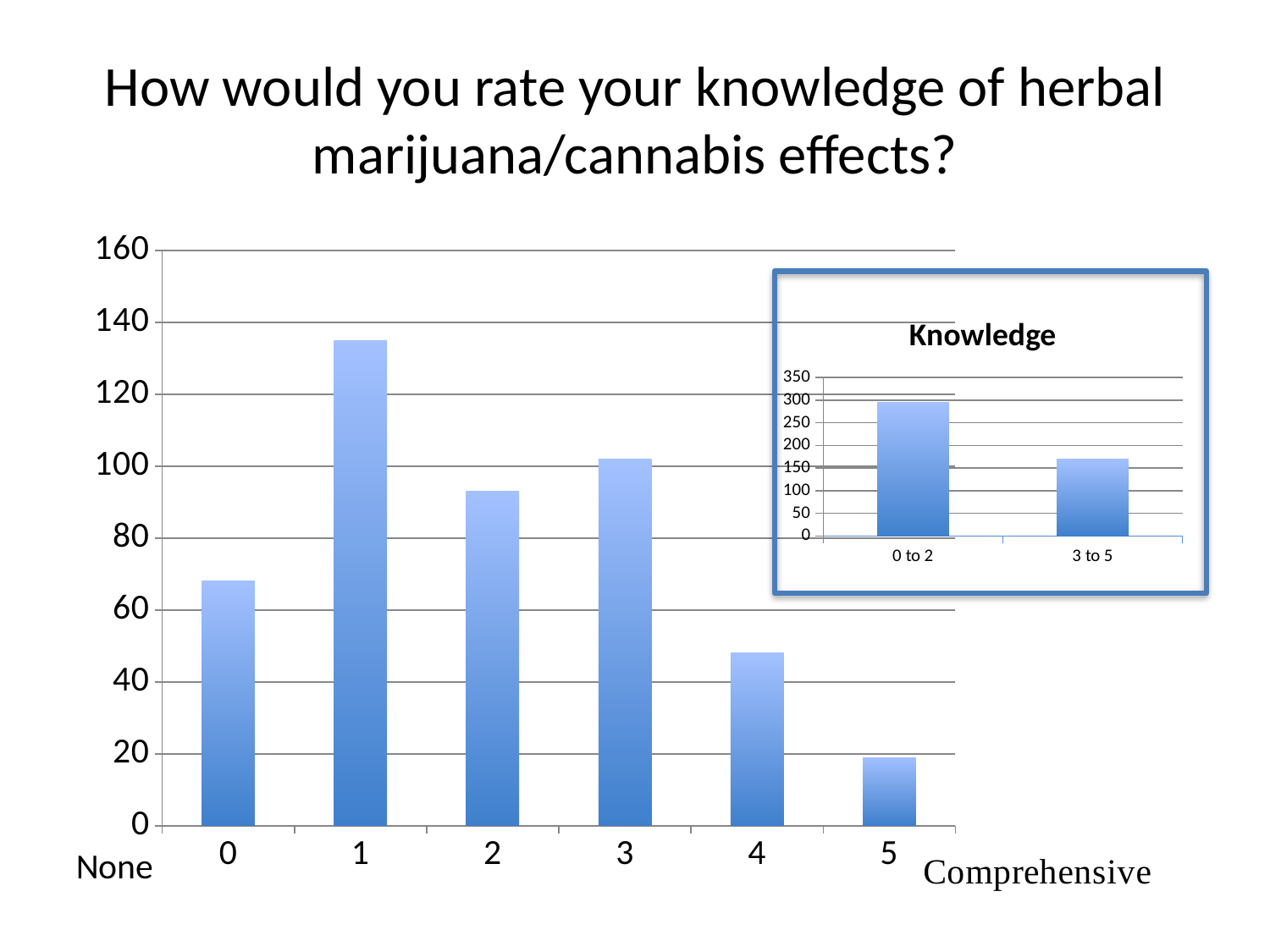
What kind of chart is the main chart on the slide? bar chart In the main chart, is the value for rating 0 greater or less than 60? greater In the inset 'Knowledge' chart, which category has the higher bar? 0 to 2 In the main chart, which is larger, the value for rating 3 or the value for rating 4? 3 How many rating categories are shown on the x axis of the main chart? 6 In the main chart, which rating category has the lowest bar? 5 In the inset 'Knowledge' chart, is the value for '0 to 2' greater or less than 250? greater In the main chart, which rating category has the highest bar? 1 In the main chart, is the value for rating 2 greater or less than 100? less